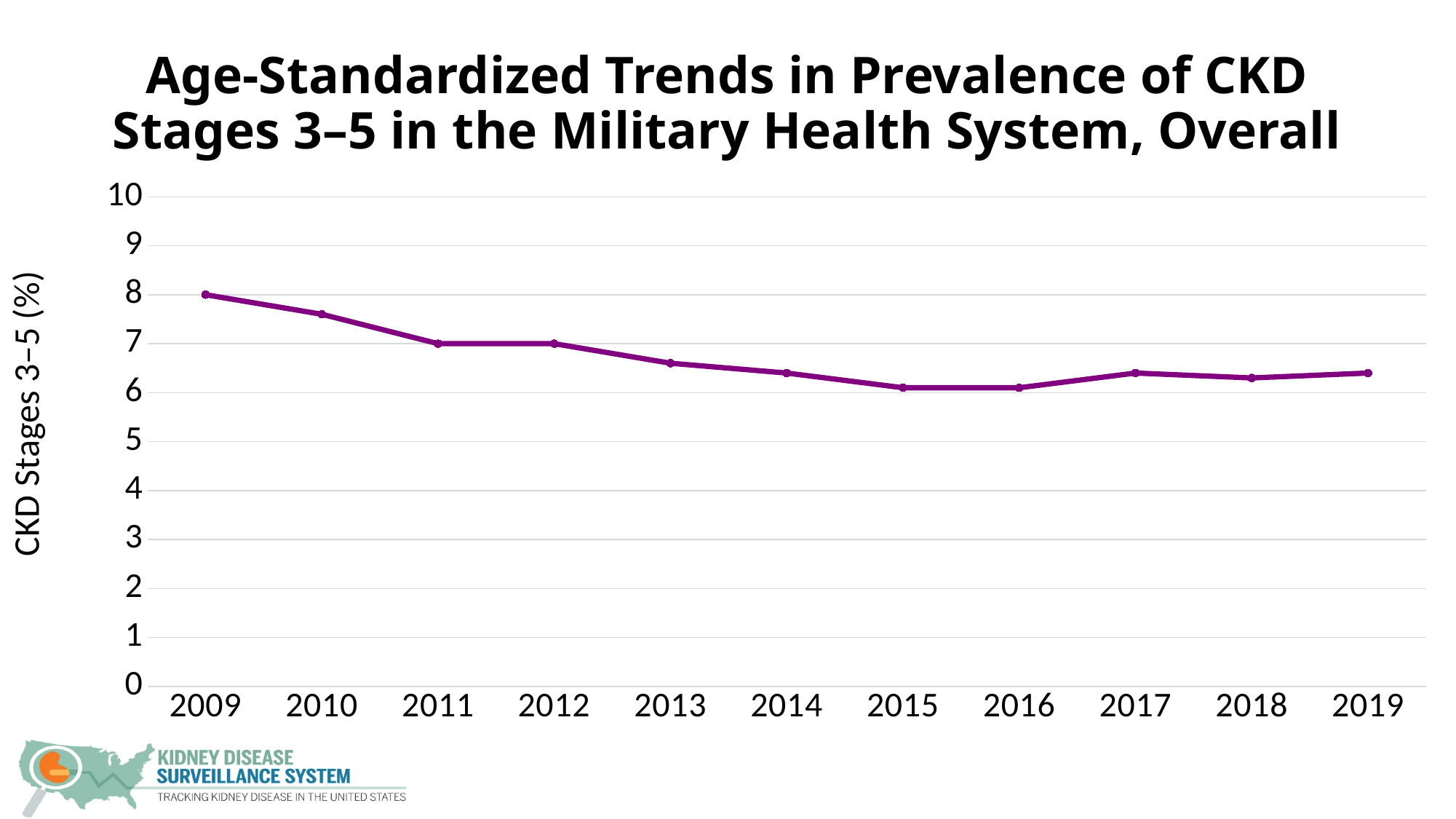
Which year has the highest CKD Stages 3–5 prevalence? 2009 How many years are plotted on the x axis? 11 Is the value for 2010 greater or less than 7? greater What kind of chart is shown on the slide? line chart Which year has the larger value, 2010 or 2014? 2010 What is the CKD Stages 3–5 prevalence (%) for 2011? 7 Is the value for 2019 greater or less than 6? greater Is the value for 2015 greater or less than 7? less Which year has the larger value, 2009 or 2019? 2009 What is the label on the y axis? CKD Stages 3–5 (%) What is the CKD Stages 3–5 prevalence (%) for 2009? 8 Does the prevalence rise or fall from 2009 to 2015? fall